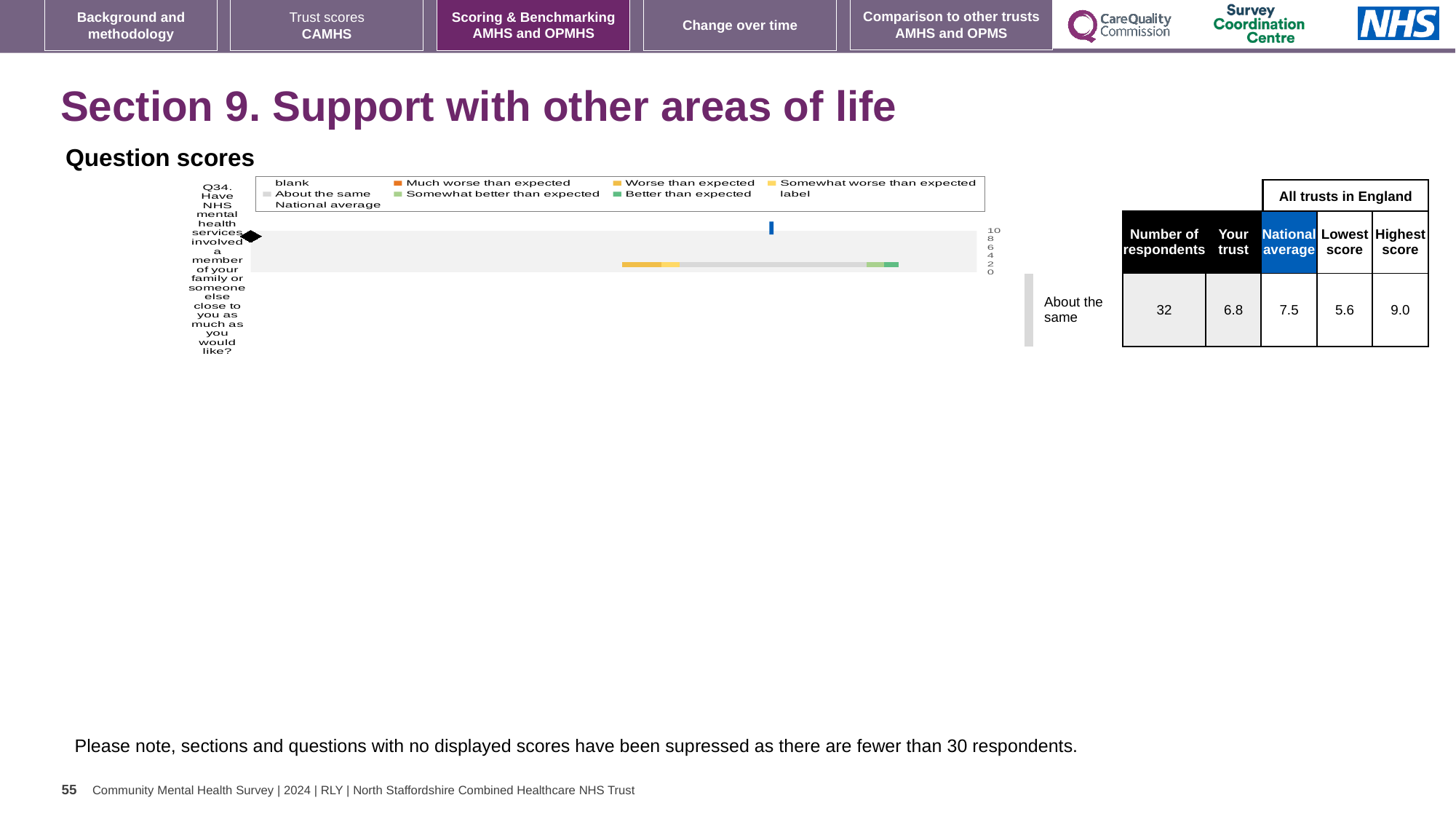
What is the maximum value shown on the score axis of the Question scores chart? 10 What kind of chart is used to show the Q34 question score? bar chart Which benchmark category is the trust's Q34 score labelled as in the Question scores chart? About the same In the Question scores chart legend, which category is shown in dark green? Better than expected How many questions (categories) are plotted in the Question scores chart? 1 Which question is plotted in the Question scores chart? Q34. Have NHS mental health services involved a member of your family or someone else close to you as much as you would like?